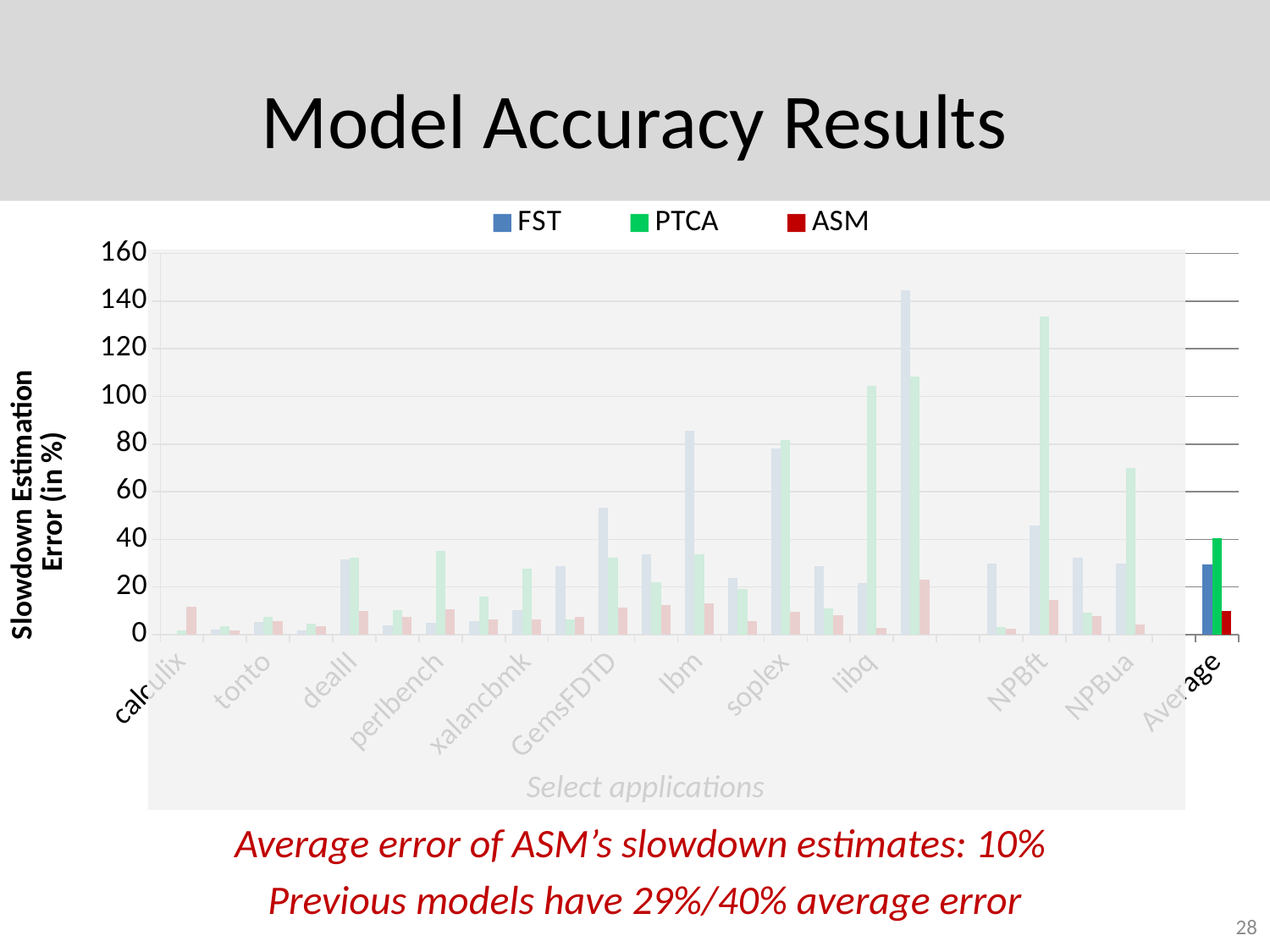
What is the average error for the PTCA model according to the slide? 40% What kind of chart is shown on the slide? bar chart Which series has the highest value in the Average group? PTCA What is the average error of ASM's slowdown estimates shown on the slide? 10% Which series has the lowest value in the Average group? ASM Is the value for FST in the Average group greater or less than 20? greater How many series does the legend list? 3 What is the difference between the average error of PTCA and the average error of ASM? 30% Is the value for ASM in the Average group greater or less than 20? less What is the average error for the FST model according to the slide? 29% In the Average group, is the FST bar or the PTCA bar taller? PTCA What is the title of the vertical axis? Slowdown Estimation Error (in %)